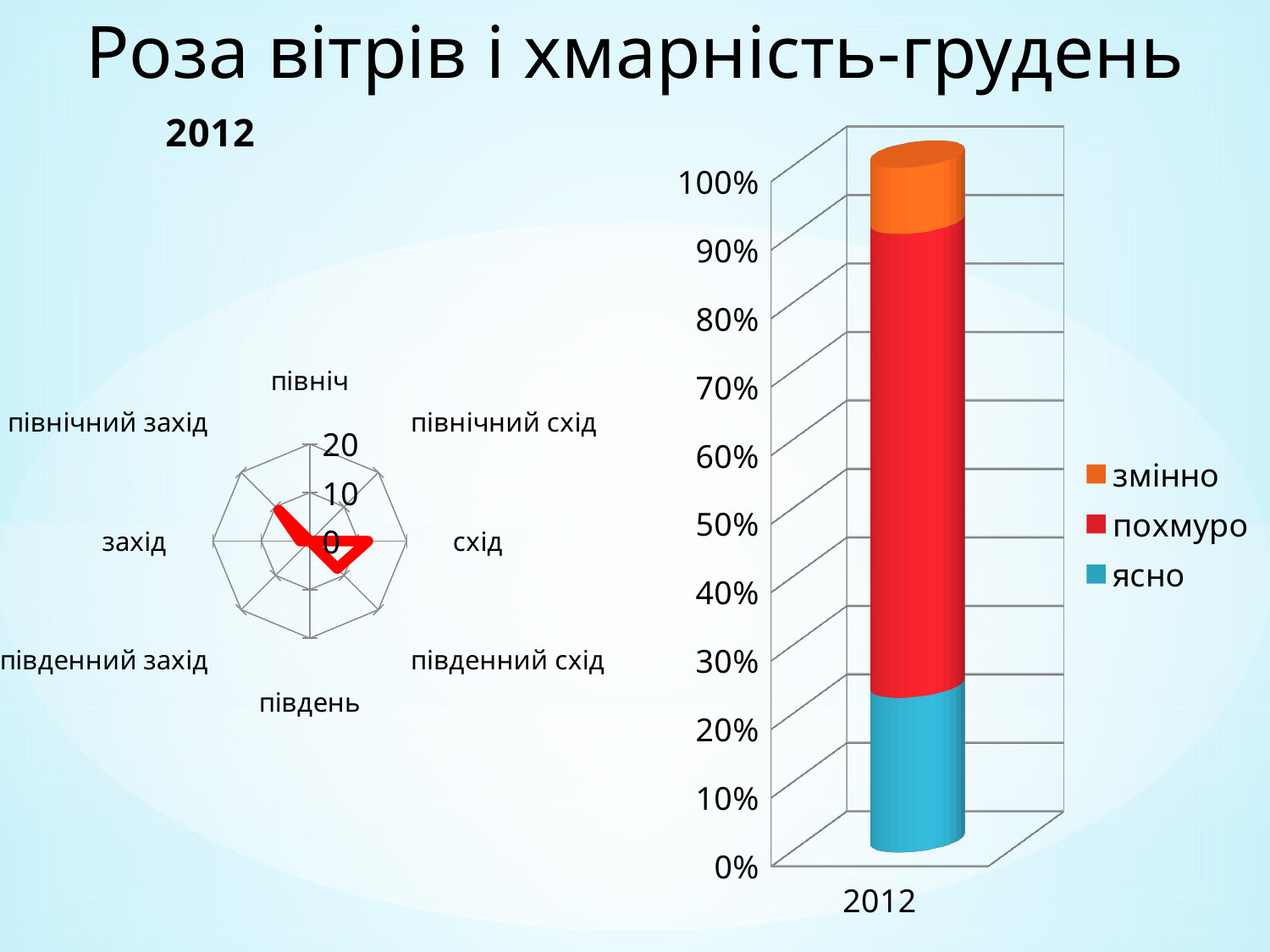
How many series does the legend of the right-hand bar chart list? 3 How many categories are shown on the x axis of the right-hand bar chart? 1 In the left-hand radar chart, is the value for північний захід greater or less than 20? less In the right-hand bar chart, is the value for ясно greater or less than 30%? less In the right-hand bar chart, is the value for змінно greater or less than 20%? less In the right-hand bar chart, which series takes up the largest part of the stacked bar? похмуро What kind of chart is the chart on the left of the slide? radar chart In the right-hand bar chart, which series takes up the smallest part of the stacked bar? змінно In the right-hand bar chart, which is larger, the ясно segment or the похмуро segment? похмуро How many direction categories does the left-hand radar chart have? 8 What kind of chart is the chart on the right of the slide? bar chart